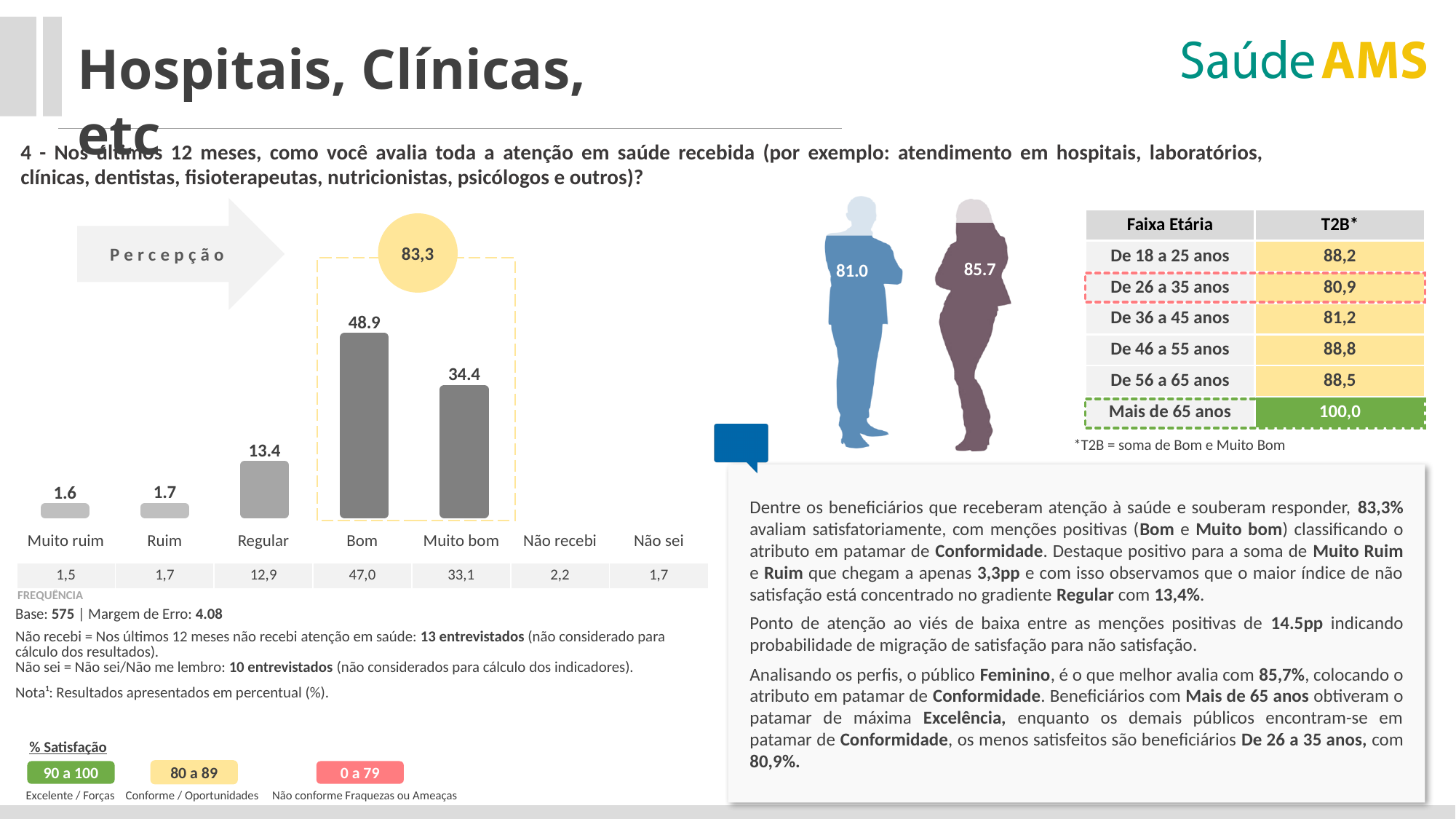
What type of chart is used to show the evaluation categories? Bar chart Which is larger, the value for Regular or the value for Muito bom? Muito bom What is the value for Regular in the bar chart? 13.4 Which category has the highest value in the bar chart? Bom What is the value for Muito bom in the bar chart? 34.4 What is the value for Bom in the bar chart? 48.9 What is the value for Muito ruim in the bar chart? 1.6 Which category has the lowest value among the plotted bars? Muito ruim What is the combined value of Muito ruim and Ruim in the bar chart? 3.3 What value is shown in the yellow circle above the highlighted Bom and Muito bom bars? 83,3 What is the difference between the values for Bom and Muito bom? 14.5 How many bars are plotted in the bar chart? 5